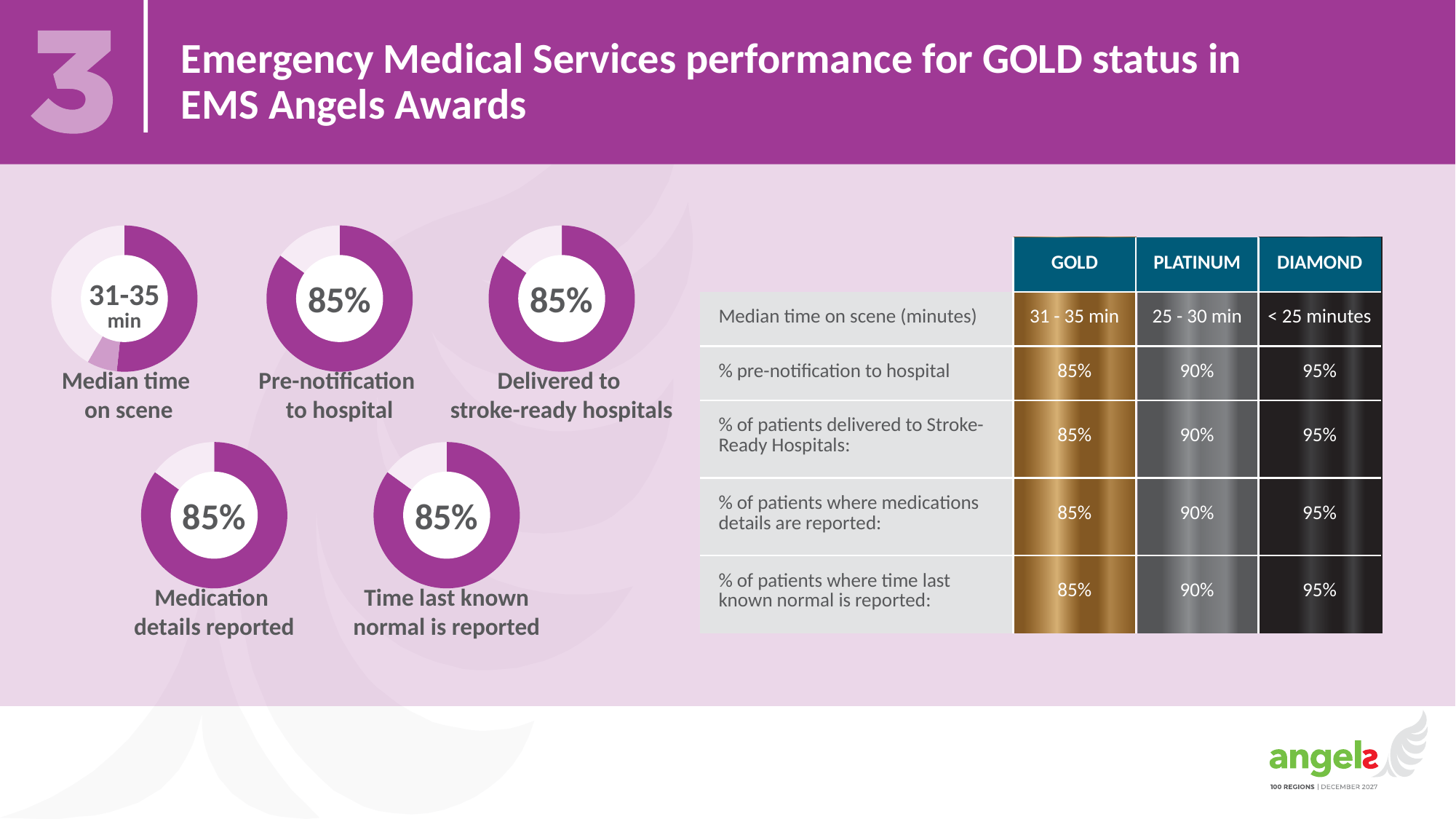
What value is shown in the centre of the 'Median time on scene' donut chart? 31-35 min Is the value in the 'Medication details reported' donut chart larger than, smaller than, or equal to the value in the 'Time last known normal is reported' donut chart? Equal How many of the donut charts on the slide display a value of 85%? 4 What value is shown in the centre of the 'Medication details reported' donut chart? 85% What kind of chart is used to display the 'Pre-notification to hospital' value? Donut chart How many donut charts are shown on the left side of the slide? 5 What is the label of the donut chart in the bottom-left position of the slide? Medication details reported What value is shown in the centre of the 'Pre-notification to hospital' donut chart? 85% Which donut chart on the slide shows a time range rather than a percentage? Median time on scene What colour is the filled portion of the donut charts on the slide? Purple What value is shown in the centre of the 'Time last known normal is reported' donut chart? 85% What value is shown in the centre of the 'Delivered to stroke-ready hospitals' donut chart? 85%